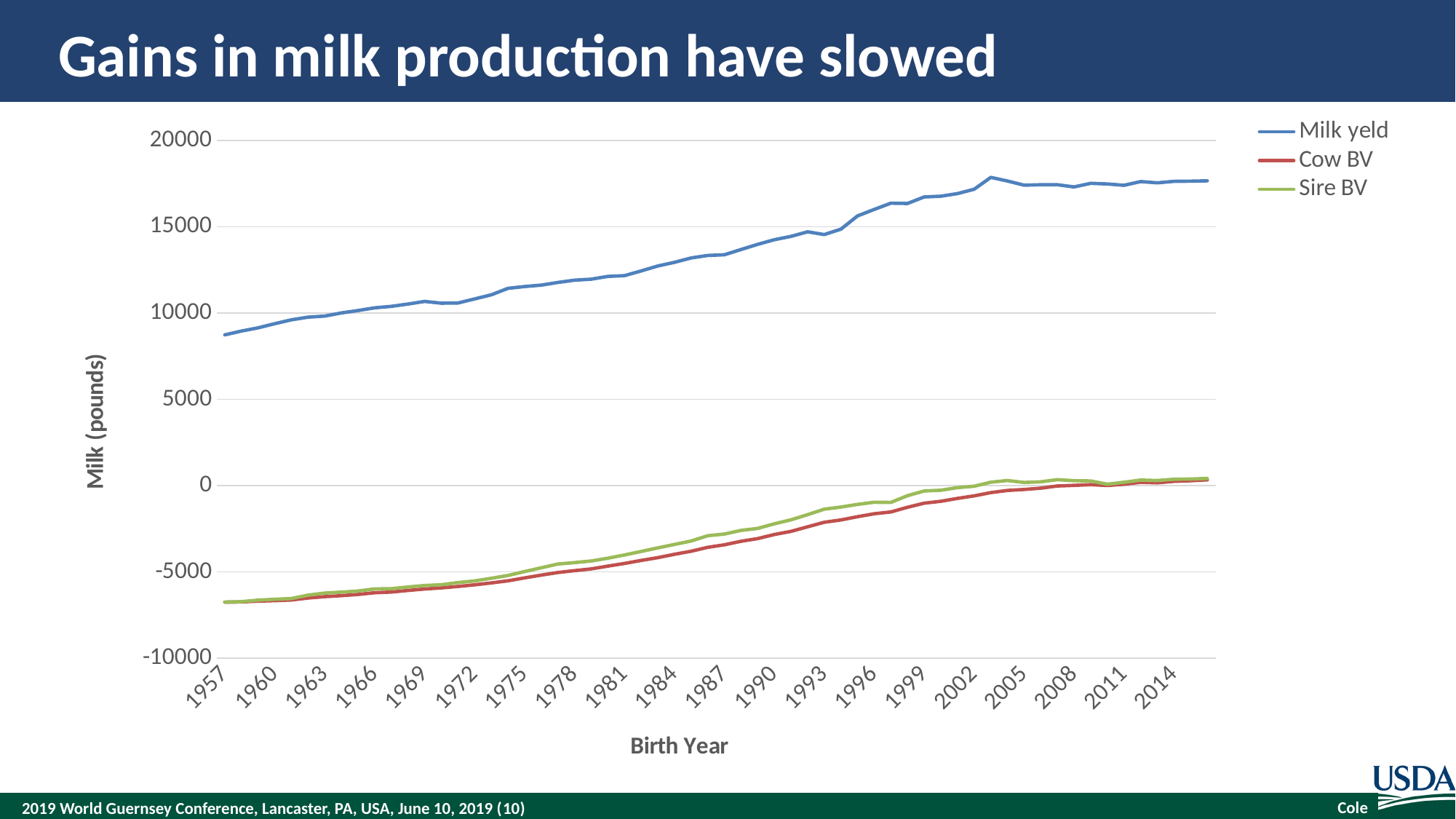
Does the Milk yeld series rise or fall from 1957 to 2014? rise Which is larger, the Milk yeld value for 2014 or the Milk yeld value for 1957? 2014 What is the label on the vertical axis? Milk (pounds) What is the title of the slide's chart? Gains in milk production have slowed Is the Cow BV value for 1957 greater or less than -5000? less Does the Cow BV series rise or fall across the birth years shown? rise How many series does the legend list? 3 Is the Milk yeld value for 1957 greater or less than 10000? less In 1990, which series has the higher value, Sire BV or Cow BV? Sire BV Is the Milk yeld value for 2014 greater or less than 15000? greater What kind of chart is shown on the slide? line chart